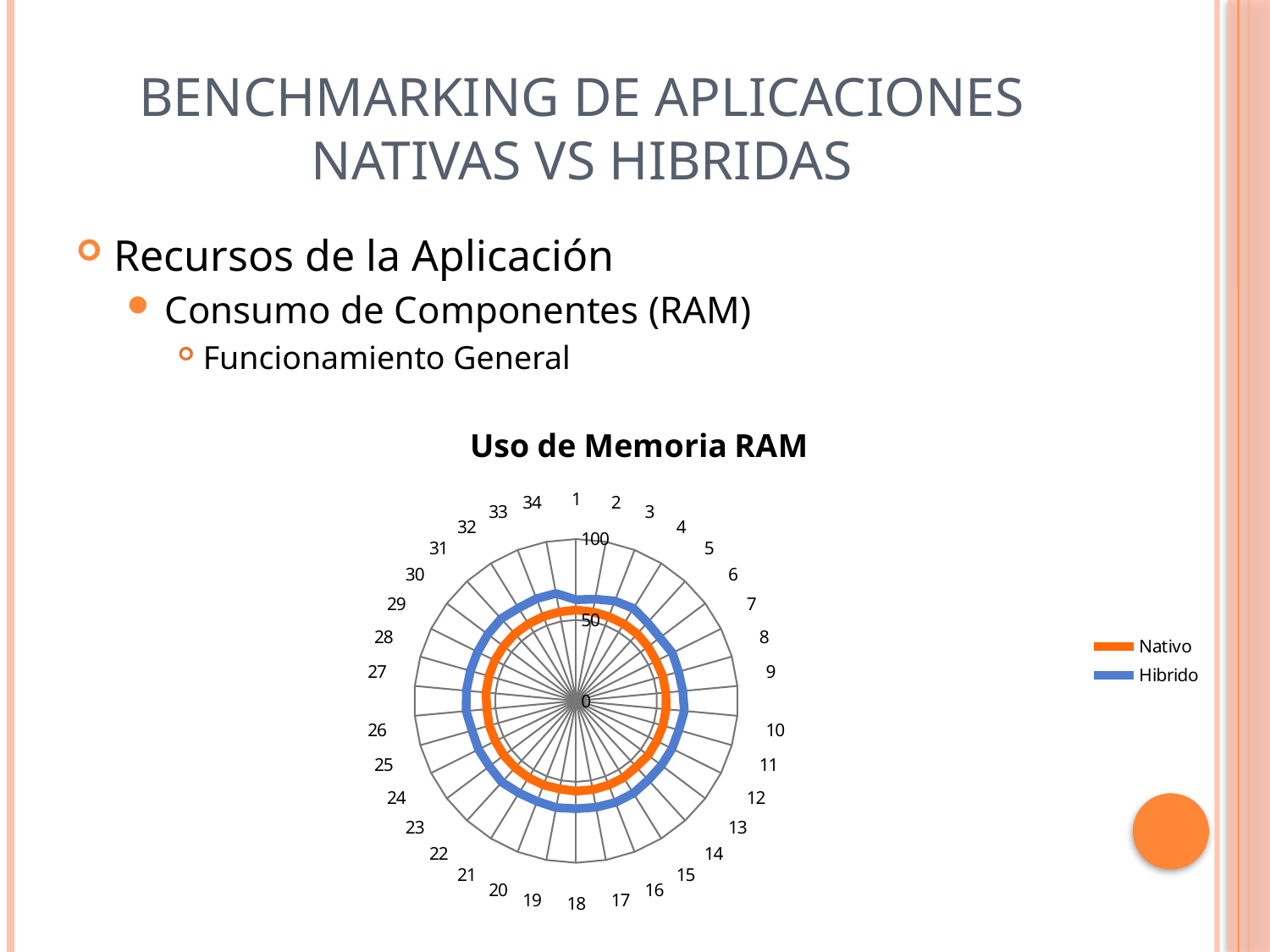
At category 1, which series has the larger value, Nativo or Hibrido? Hibrido What kind of chart is shown on the slide? Radar chart At category 18, which series has the larger value, Nativo or Hibrido? Hibrido What is the title of the chart? Uso de Memoria RAM Is the Hibrido value at category 26 greater or less than 100? less How many categories (points) are plotted around the radar chart? 34 Is the Hibrido value at category 9 greater or less than 50? greater Is the Nativo value at category 9 greater or less than 100? less At category 27, which series has the larger value, Nativo or Hibrido? Hibrido How many series does the legend of the chart list? 2 What are the two series named in the chart legend? Nativo and Hibrido